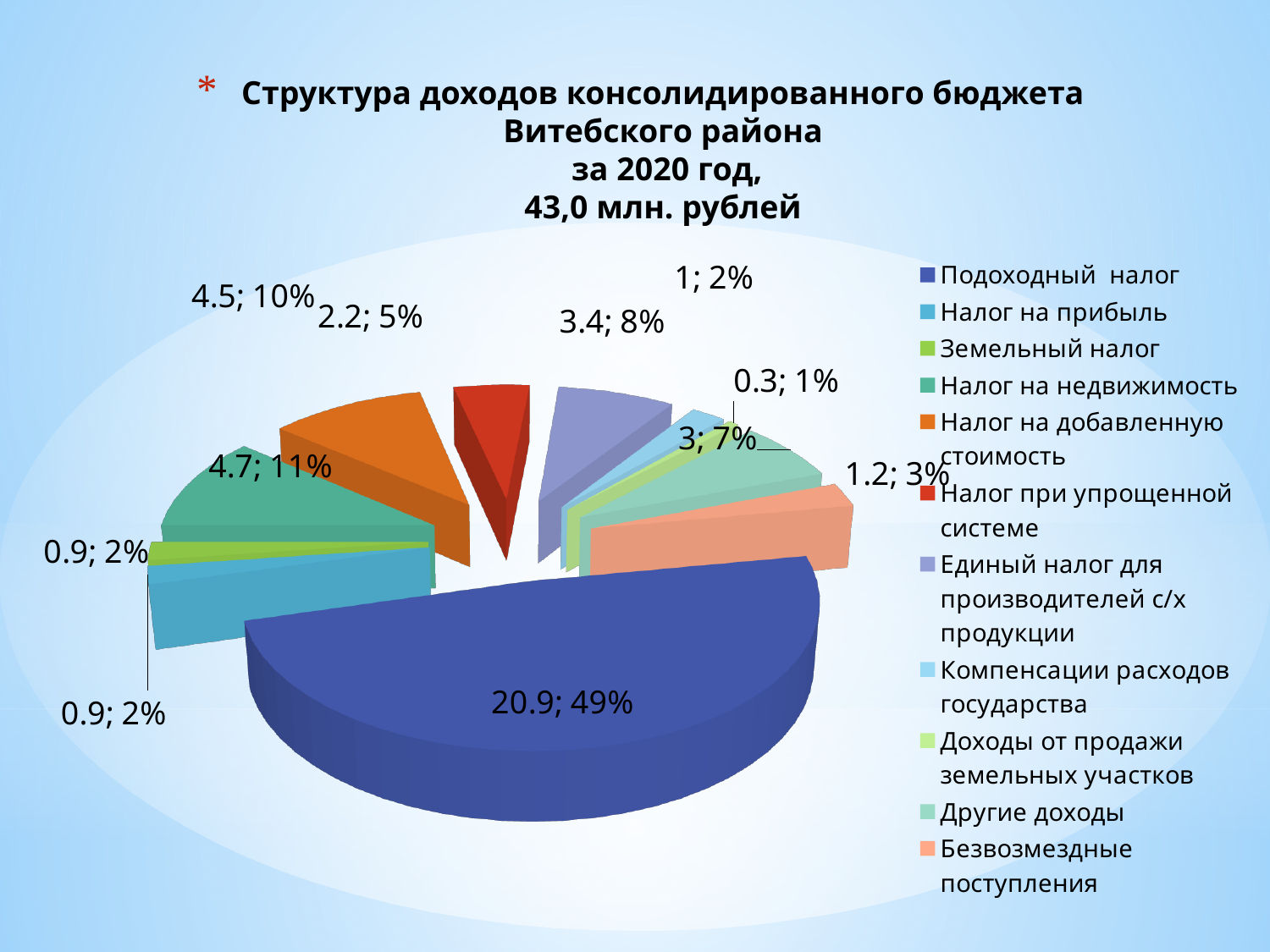
Which is larger: Единый налог для производителей с/х продукции or Другие доходы? Единый налог для производителей с/х продукции What share of the pie does Подоходный налог have? 49% What total amount is stated in the chart title? 43,0 млн. рублей What is the value shown for Подоходный налог? 20.9 What is the value shown for Налог на недвижимость? 4.7 What is the value shown for Безвозмездные поступления? 1.2 Which category has the smallest slice of the pie? Доходы от продажи земельных участков How many categories does the legend of the pie chart list? 11 Which category has the largest slice of the pie? Подоходный налог What type of chart is shown on the slide? pie chart What share of the pie does Налог на добавленную стоимость have? 10% What is the difference between the values for Налог на недвижимость and Налог на добавленную стоимость? 0.2